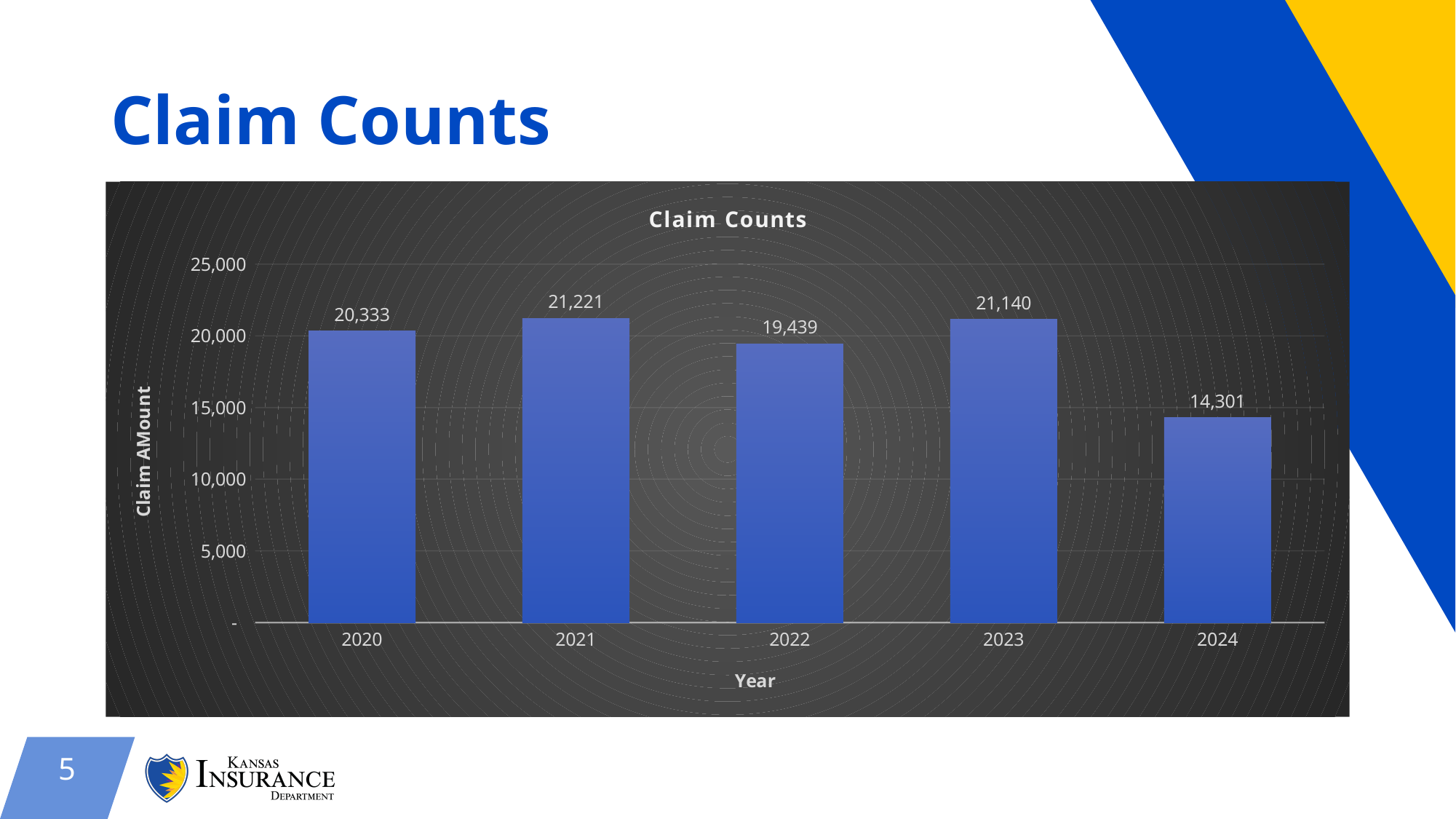
What is the claim count for 2020? 20,333 Which year has a larger claim count, 2020 or 2022? 2020 What is the label on the vertical axis of the chart? Claim AMount What kind of chart is shown on the slide? bar chart Which year has the lowest claim count? 2024 What is the claim count for 2022? 19,439 What is the difference between the claim counts for 2023 and 2022? 1,701 What is the difference between the claim counts for 2021 and 2024? 6,920 How many years are shown on the chart? 5 Which year has the highest claim count? 2021 What is the claim count for 2024? 14,301 Is the claim count for 2024 greater or less than 15,000? less